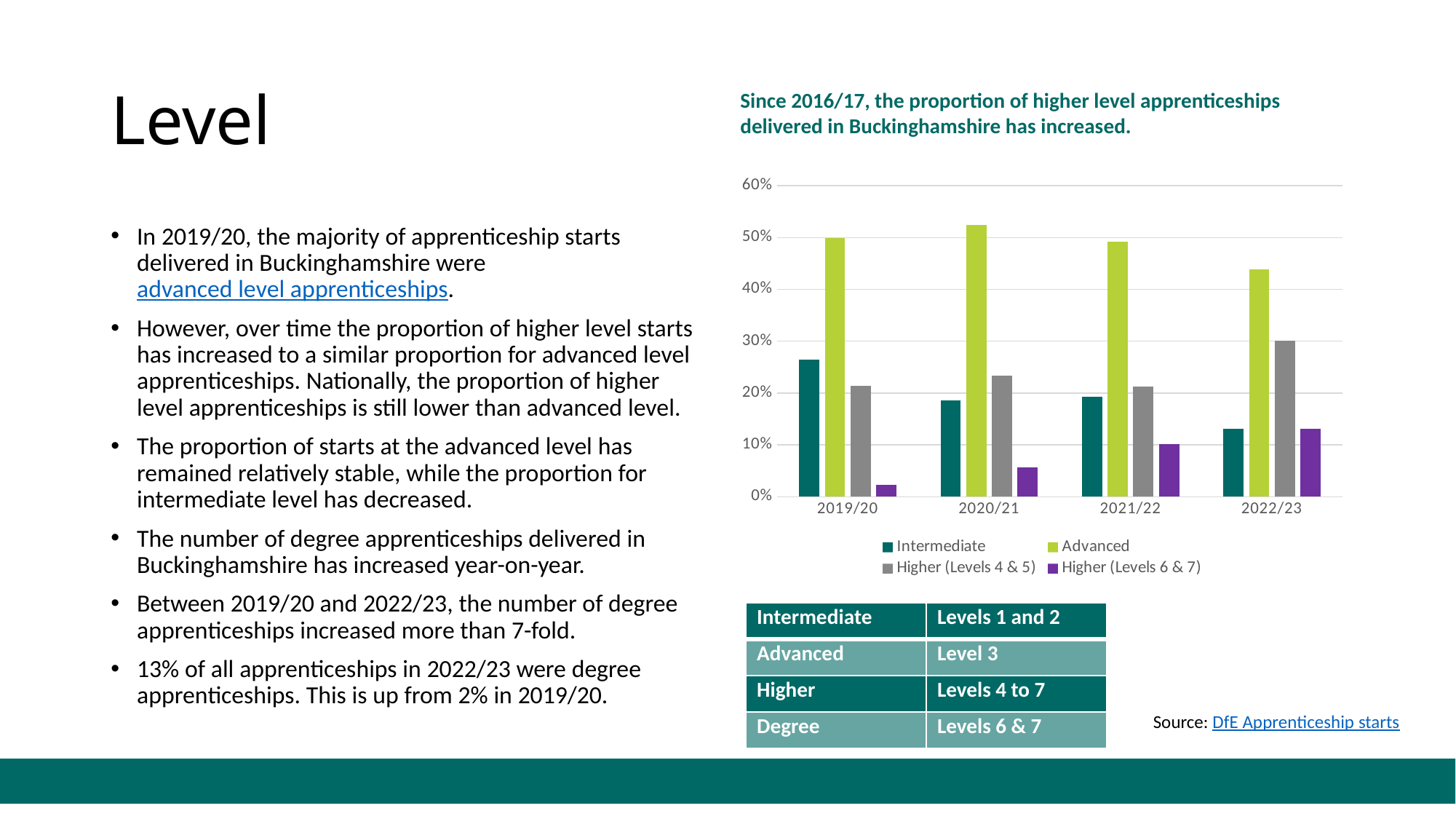
Which is larger: the Intermediate value in 2019/20 or the Intermediate value in 2022/23? 2019/20 Is the value for Higher (Levels 6 & 7) in 2019/20 greater or less than 10%? less Is the value for Higher (Levels 4 & 5) in 2022/23 greater or less than 20%? greater How many series does the chart legend list? 4 What is the title of the chart? Since 2016/17, the proportion of higher level apprenticeships delivered in Buckinghamshire has increased. What kind of chart is shown on the slide? Bar chart Is the value for Advanced in 2022/23 greater or less than 50%? less Which apprenticeship level has the lowest proportion in 2019/20? Higher (Levels 6 & 7) Which apprenticeship level has the highest proportion in 2019/20? Advanced Does the proportion for Higher (Levels 6 & 7) rise or fall from 2019/20 to 2022/23? Rise How many academic years are shown on the x axis of the chart? 4